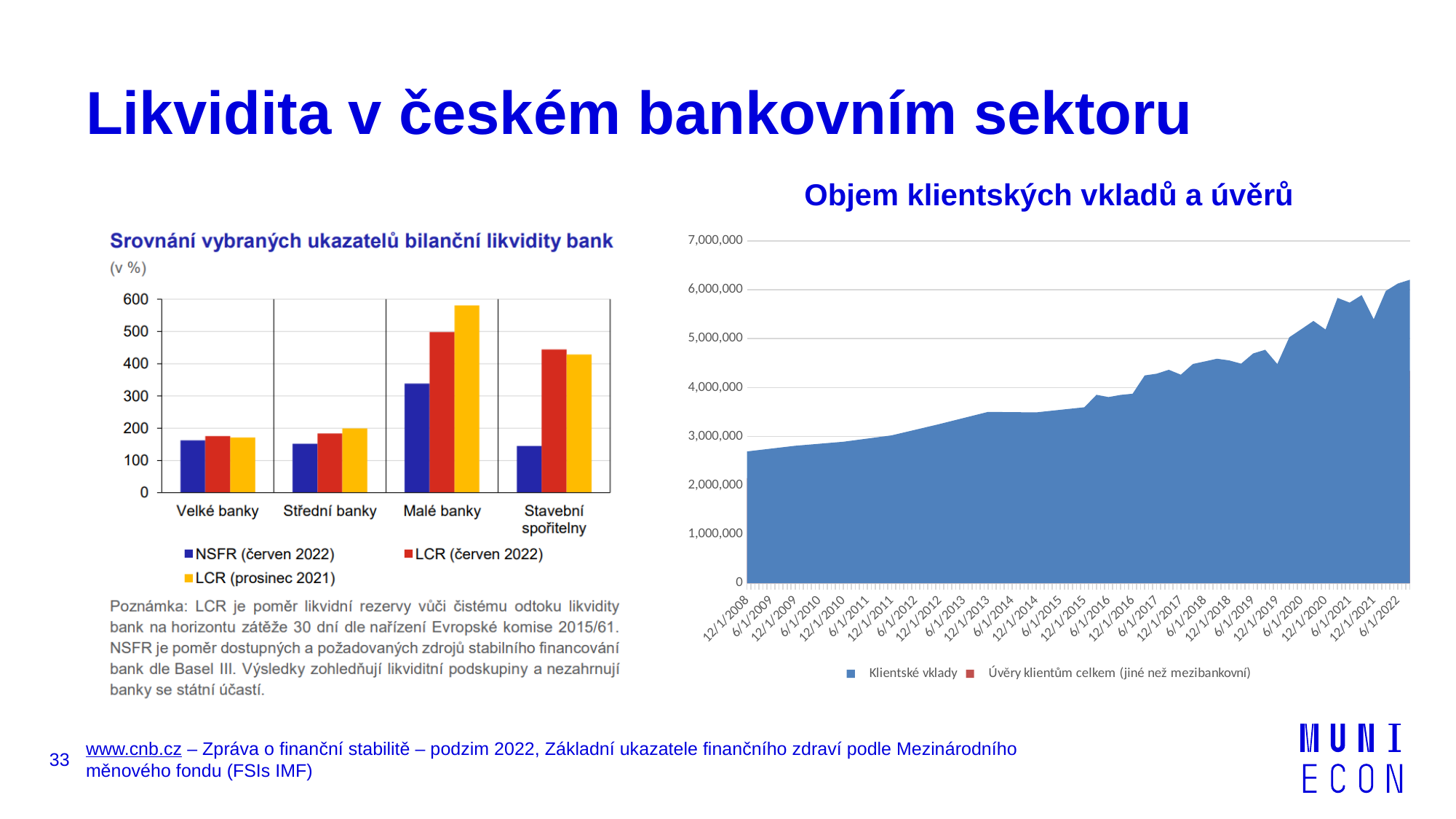
What kind of chart is the right chart titled 'Objem klientských vkladů a úvěrů'? area chart In the left chart 'Srovnání vybraných ukazatelů bilanční likvidity bank', for Malé banky, which is larger: LCR (červen 2022) or LCR (prosinec 2021)? LCR (prosinec 2021) In the right chart 'Objem klientských vkladů a úvěrů', do the values generally rise or fall from 12/1/2008 to 6/1/2022? rise In the left chart 'Srovnání vybraných ukazatelů bilanční likvidity bank', is the NSFR (červen 2022) value for Velké banky greater or less than 200? less How many series does the legend of the left chart 'Srovnání vybraných ukazatelů bilanční likvidity bank' list? 3 In the left chart 'Srovnání vybraných ukazatelů bilanční likvidity bank', which category has the highest LCR (prosinec 2021) value? Malé banky In the left chart 'Srovnání vybraných ukazatelů bilanční likvidity bank', is the NSFR (červen 2022) value for Malé banky greater or less than 300? greater What kind of chart is the left chart titled 'Srovnání vybraných ukazatelů bilanční likvidity bank'? bar chart In the left chart 'Srovnání vybraných ukazatelů bilanční likvidity bank', is the LCR (červen 2022) value for Stavební spořitelny greater or less than 400? greater How many bank categories are shown on the x axis of the left chart 'Srovnání vybraných ukazatelů bilanční likvidity bank'? 4 How many series does the legend of the right chart 'Objem klientských vkladů a úvěrů' list? 2